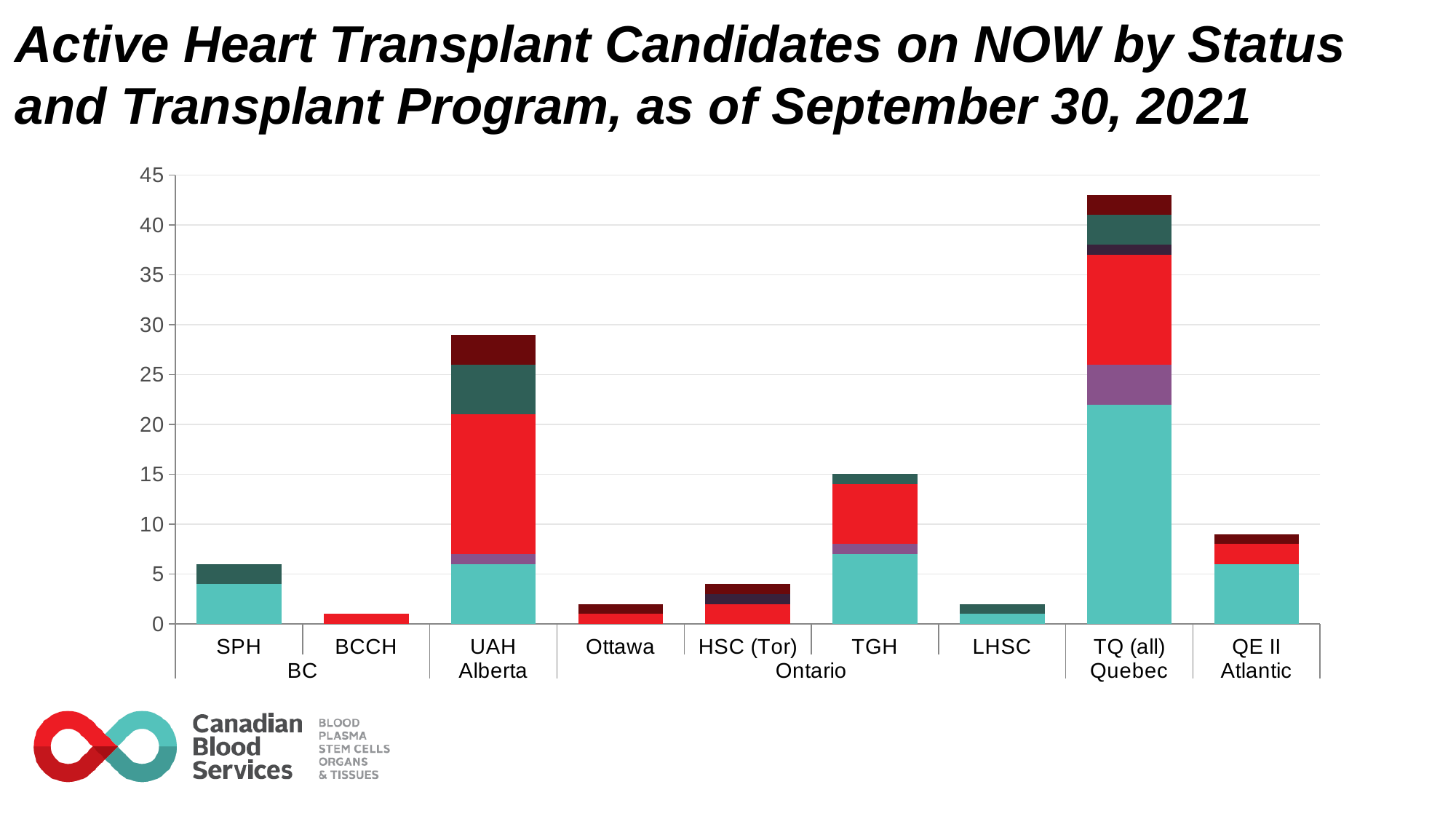
What kind of chart is shown on the slide? Stacked bar chart Which has a larger total, UAH or TGH? UAH Which transplant program has the lowest total number of active heart transplant candidates? BCCH Which transplant program has the highest total number of active heart transplant candidates? TQ (all) Which has a larger total, QE II or LHSC? QE II Is the total for Ottawa greater or less than 5? less How many transplant programs are shown along the x axis? 9 Is the total for TGH greater or less than 10? greater Is the total for UAH greater or less than 25? greater How many provinces or regions are the transplant programs grouped into on the x axis? 5